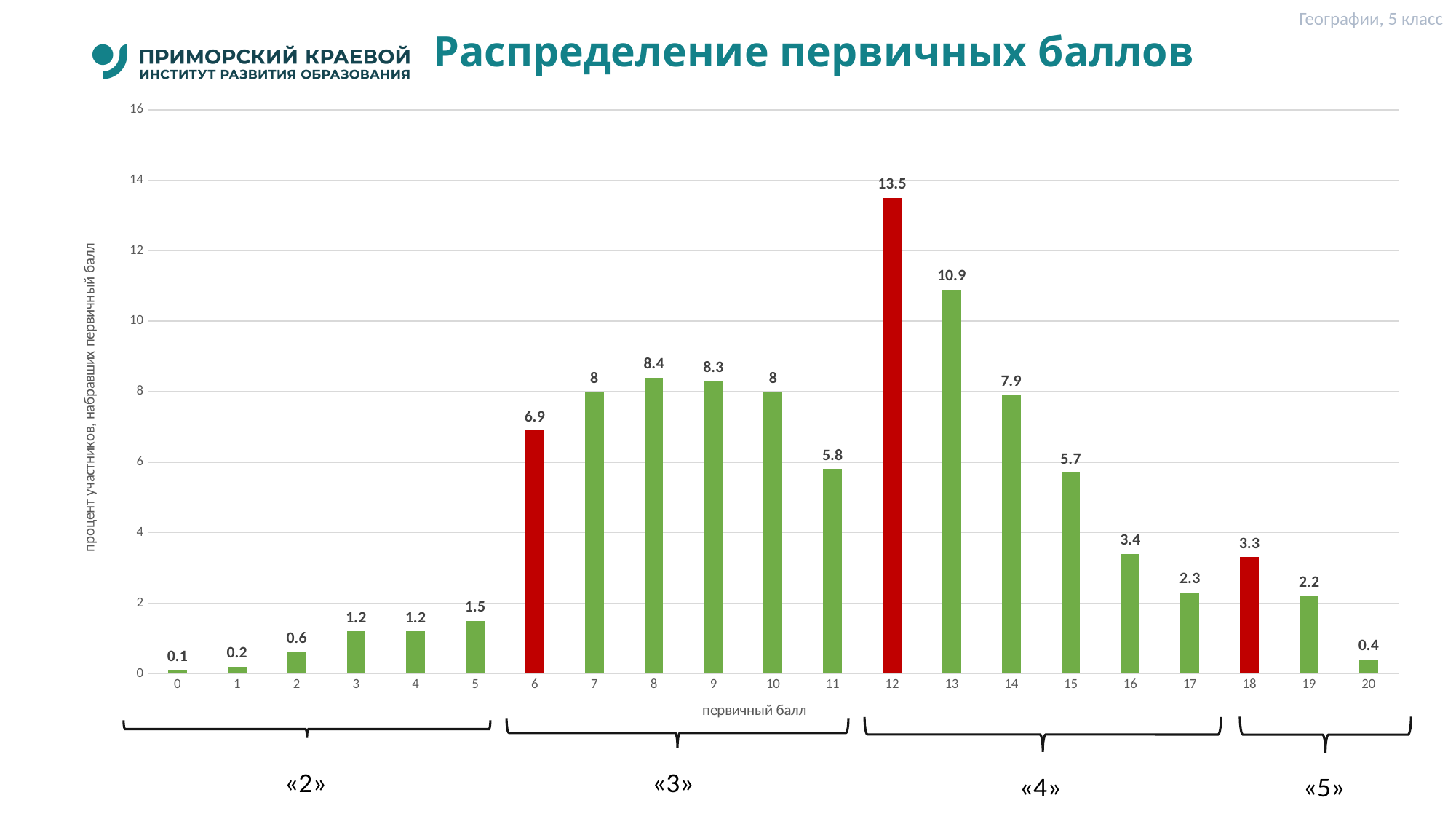
Do the values rise or fall along the x axis from primary score 12 to primary score 17? fall What is the value for primary score 6? 6.9 What is the difference between the values for primary scores 12 and 13? 2.6 Is the value for primary score 13 greater or less than 10? greater How many bars (primary score categories) are plotted in the chart? 21 What is the value for primary score 18? 3.3 Which is larger, the value for primary score 6 or for primary score 11? primary score 6 What is the value for primary score 12? 13.5 What type of chart is shown on the slide? bar chart Which primary score has the highest percentage of participants? 12 Which primary score has the lowest percentage of participants? 0 Which primary scores are shown with red bars? 6, 12 and 18